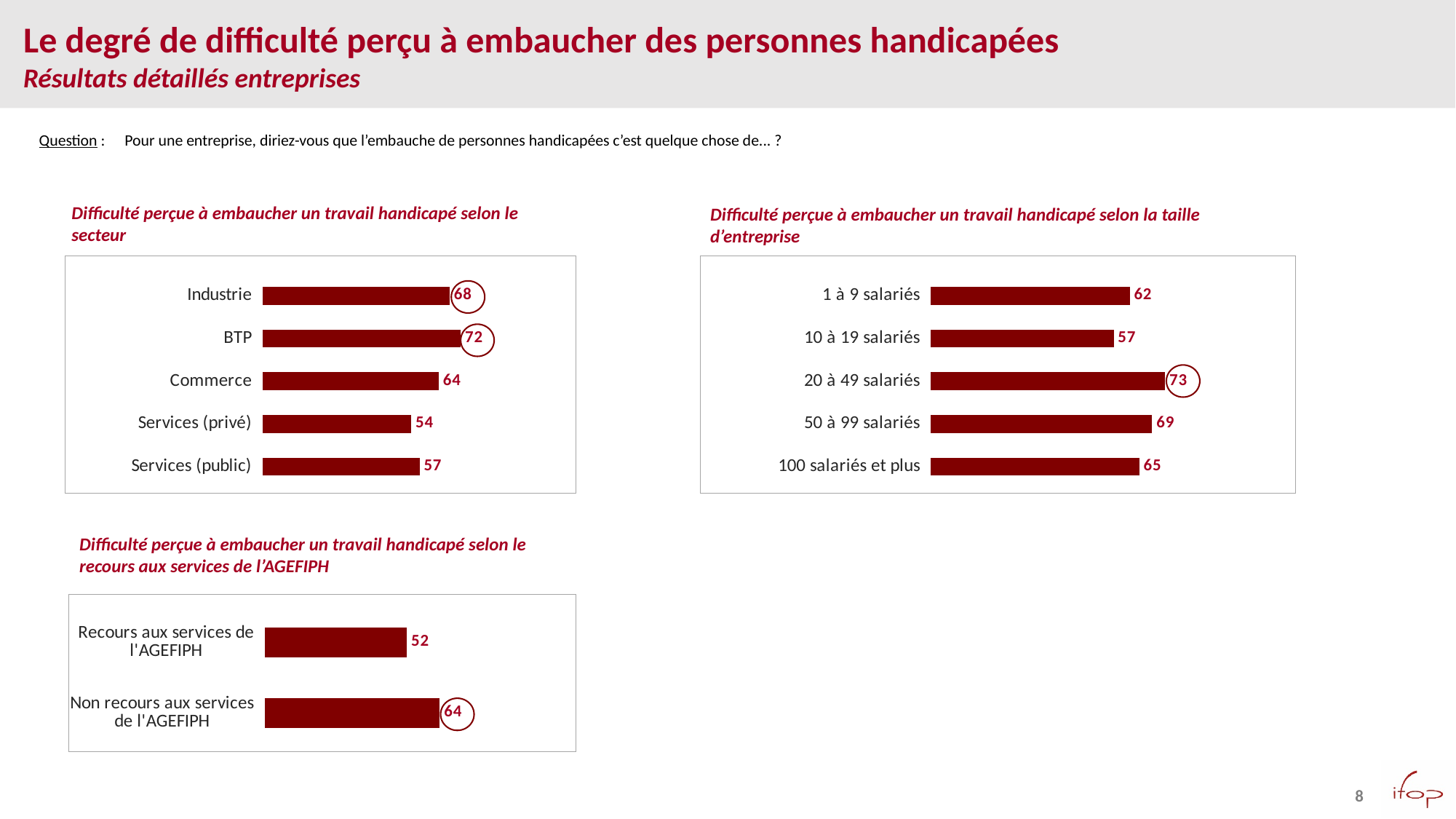
In the chart 'Difficulté perçue à embaucher un travail handicapé selon le secteur', what is the value for BTP? 72 What type of chart is used in the chart 'Difficulté perçue à embaucher un travail handicapé selon le secteur'? Bar chart In the chart 'Difficulté perçue à embaucher un travail handicapé selon la taille d'entreprise', which company size has the highest value? 20 à 49 salariés In the chart 'Difficulté perçue à embaucher un travail handicapé selon le recours aux services de l'AGEFIPH', what is the value for Recours aux services de l'AGEFIPH? 52 In the chart 'Difficulté perçue à embaucher un travail handicapé selon le secteur', which sector has the lowest value? Services (privé) In the chart 'Difficulté perçue à embaucher un travail handicapé selon la taille d'entreprise', what is the value for 50 à 99 salariés? 69 In the chart 'Difficulté perçue à embaucher un travail handicapé selon la taille d'entreprise', which is larger: 1 à 9 salariés or 10 à 19 salariés? 1 à 9 salariés In the chart 'Difficulté perçue à embaucher un travail handicapé selon le secteur', how many sectors are shown? 5 How many charts are shown on the slide? 3 In the chart 'Difficulté perçue à embaucher un travail handicapé selon le secteur', what is the difference between Industrie and Commerce? 4 In the chart 'Difficulté perçue à embaucher un travail handicapé selon la taille d'entreprise', what is the difference between 20 à 49 salariés and 100 salariés et plus? 8 In the chart 'Difficulté perçue à embaucher un travail handicapé selon le recours aux services de l'AGEFIPH', what is the difference between the two categories? 12